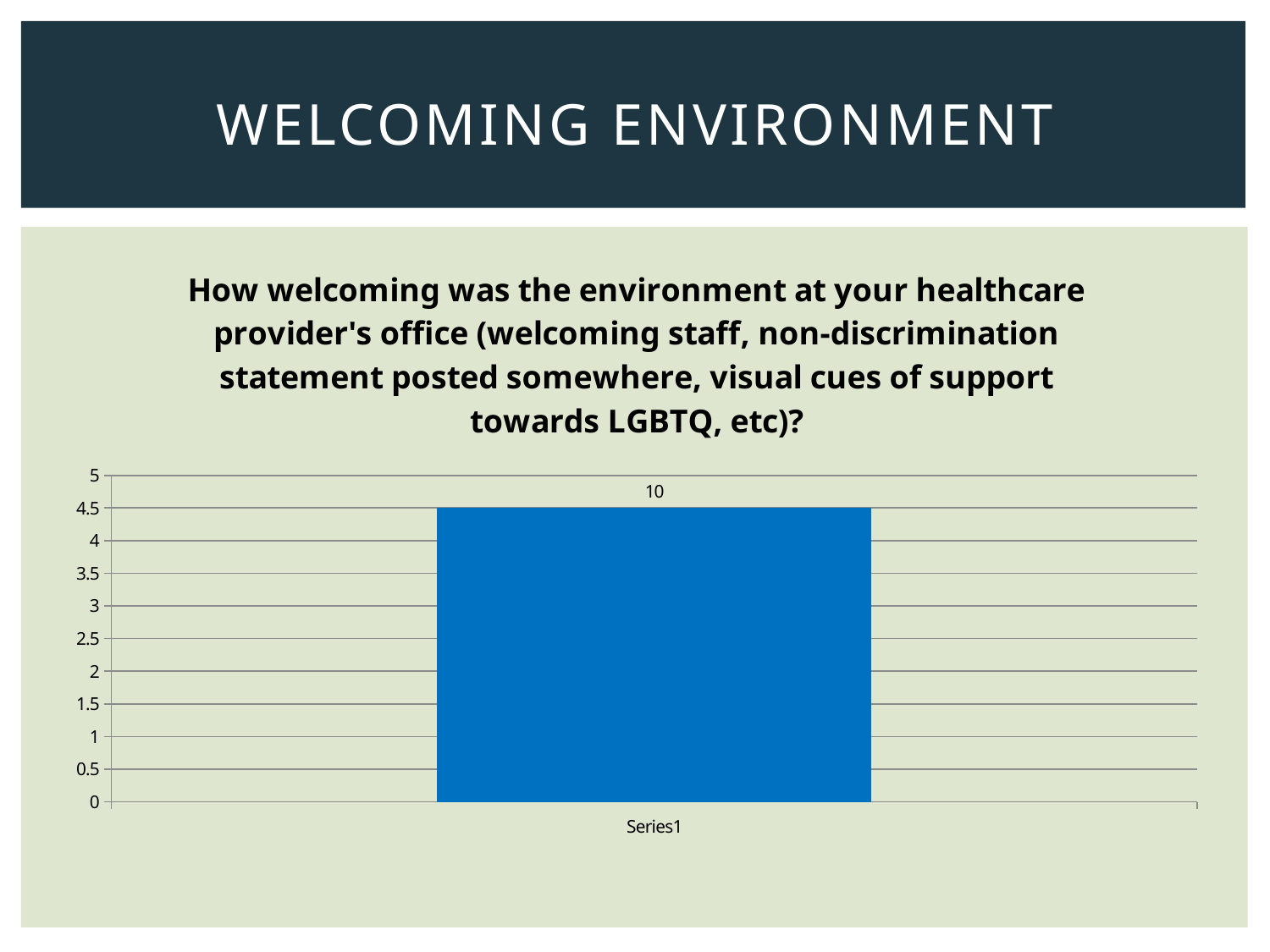
What is the category label shown on the x axis of the chart? Series1 What is the highest value shown on the chart's vertical axis? 5 How many bars are plotted in the chart? 1 What data label is printed above the bar for Series1? 10 What kind of chart is shown on the slide? bar chart What is the lowest value shown on the chart's vertical axis? 0